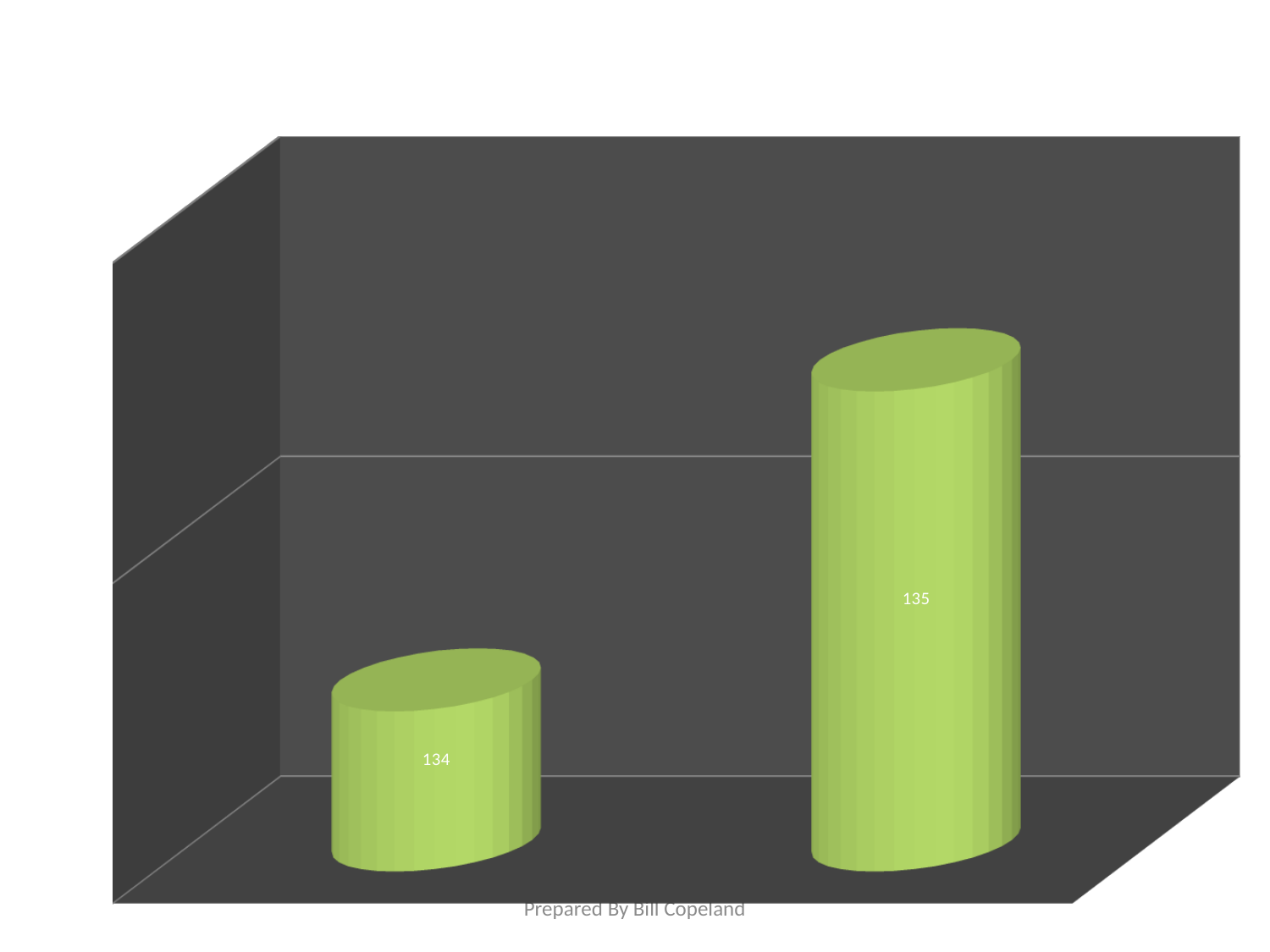
Which bar is taller, the left one or the right one? the right one What colour are the bars in the chart? green What value is labelled on the right bar? 135 What is the lowest value labelled on the chart? 134 What kind of chart is shown on the slide? bar chart What is the highest value labelled on the chart? 135 What value is labelled on the left bar? 134 What is the difference between the values of the right bar and the left bar? 1 How many bars does the chart show? 2 What text appears at the bottom of the slide below the chart? Prepared By Bill Copeland